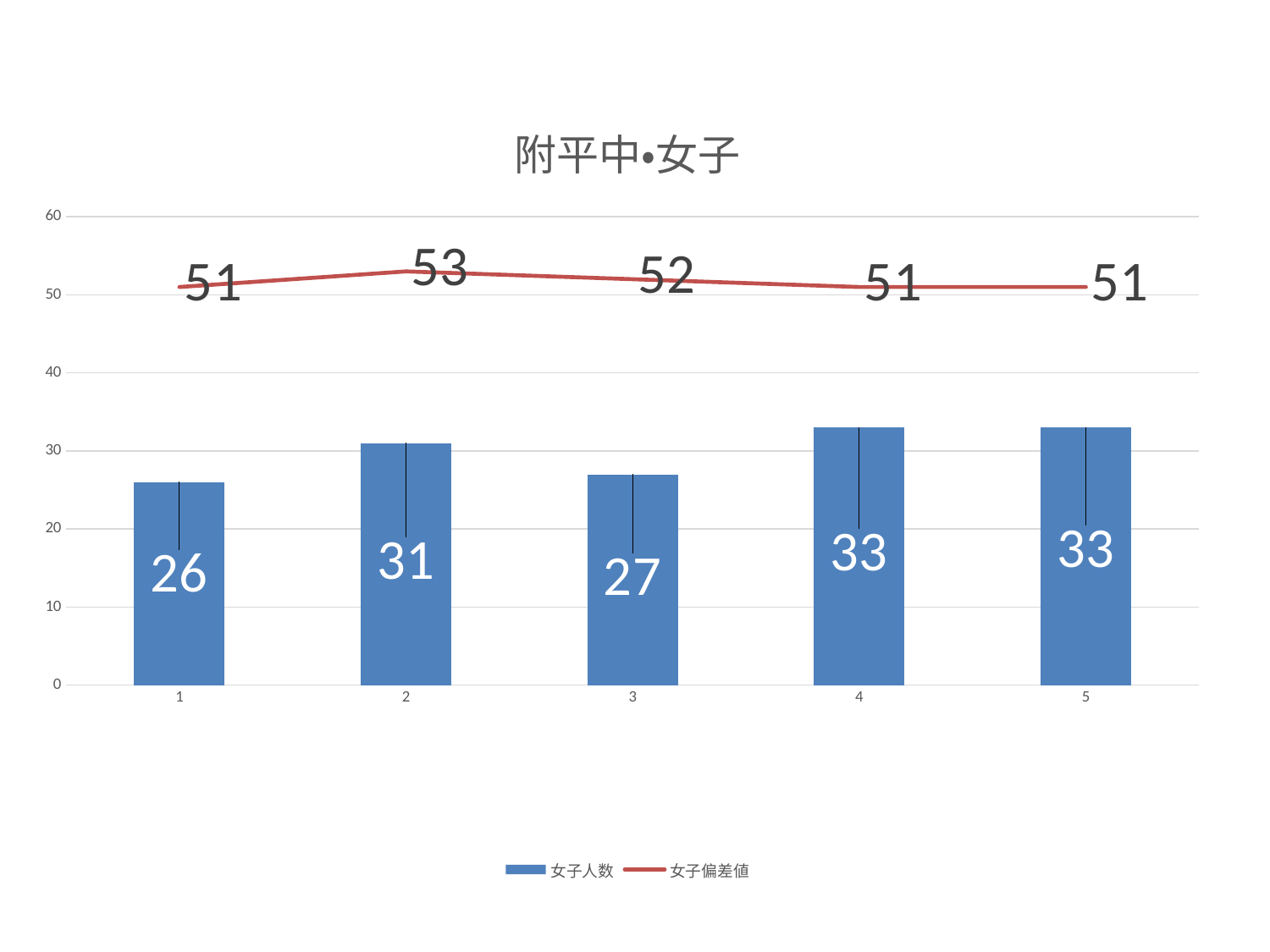
How many categories are shown on the x axis? 5 What is the title of the chart? 附平中•女子 What is the 女子人数 value for category 3? 27 What is the 女子偏差値 value for category 5? 51 Which category has the highest 女子偏差値 value? 2 What kind of chart is shown on the slide? Combined bar and line chart How many series does the legend list? 2 Which is larger, the 女子人数 value for category 2 or for category 3? category 2 What is the 女子人数 value for category 1? 26 What is the 女子偏差値 value for category 2? 53 Which category has the lowest 女子人数 value? 1 What is the difference between the 女子人数 values for category 2 and category 1? 5